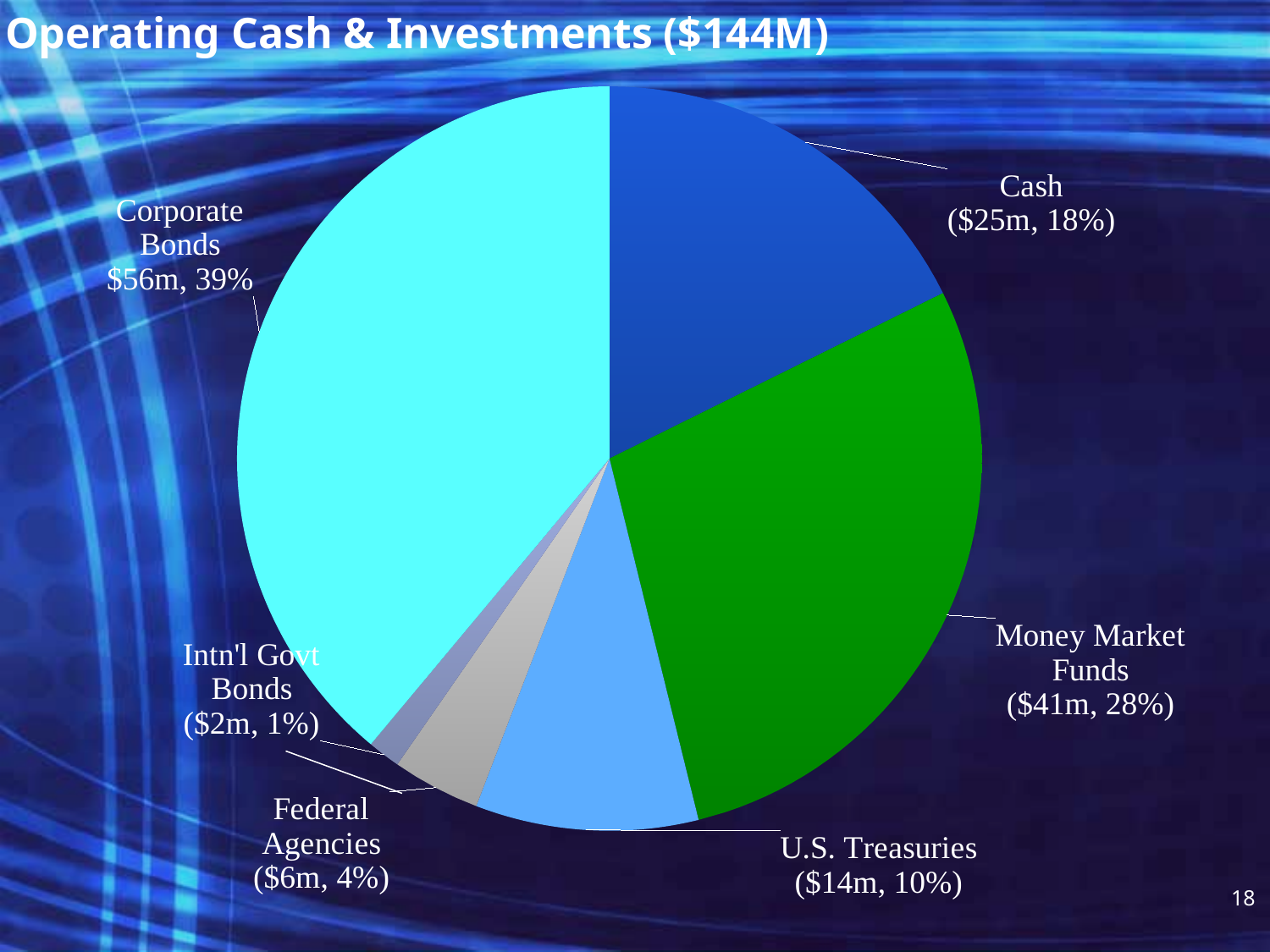
What is the value for Corporate Bonds? $56m Which is larger, Cash or U.S. Treasuries? Cash What share of the pie is Federal Agencies? 4% Which category has the smallest slice? Intn'l Govt Bonds What is the difference in percentage share between Cash and U.S. Treasuries? 8% Which category has the largest slice? Corporate Bonds What share of the pie is Money Market Funds? 28% What kind of chart is shown on the slide? pie chart How many slices does the pie chart have? 6 What is the title of the chart? Operating Cash & Investments ($144M) What is the value for U.S. Treasuries? $14m What is the difference in value between Corporate Bonds and Money Market Funds? $15m